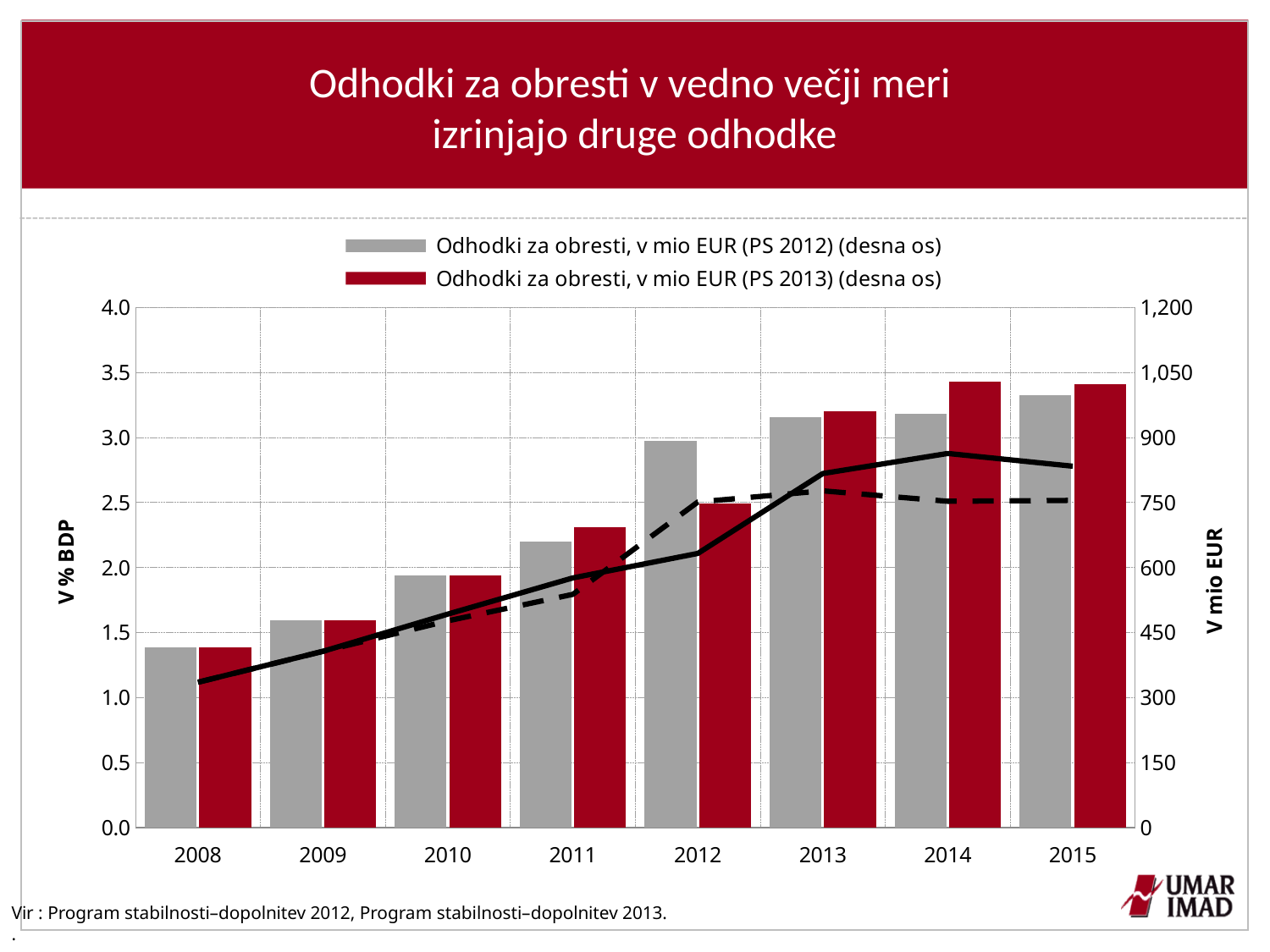
How many years are shown on the x axis? 8 Which year has the lowest value for 'Odhodki za obresti, v mio EUR (PS 2012)'? 2008 Is the value for 'Odhodki za obresti, v mio EUR (PS 2013)' in 2014 greater or less than 1,050? less In 2014, which is larger: the PS 2012 bar or the PS 2013 bar? PS 2013 In 2012, which is larger: the PS 2012 bar or the PS 2013 bar? PS 2012 How many series does the legend list? 2 What kind of chart is shown on the slide? bar chart combined with line series Is the value for 'Odhodki za obresti, v mio EUR (PS 2012)' in 2008 greater or less than 450? less Is the value for 'Odhodki za obresti, v mio EUR (PS 2012)' in 2012 greater or less than 750? greater Which year has the highest value for 'Odhodki za obresti, v mio EUR (PS 2012)'? 2015 What is the label of the right-hand vertical axis? V mio EUR Do the PS 2012 bars generally rise or fall from 2008 to 2015? rise